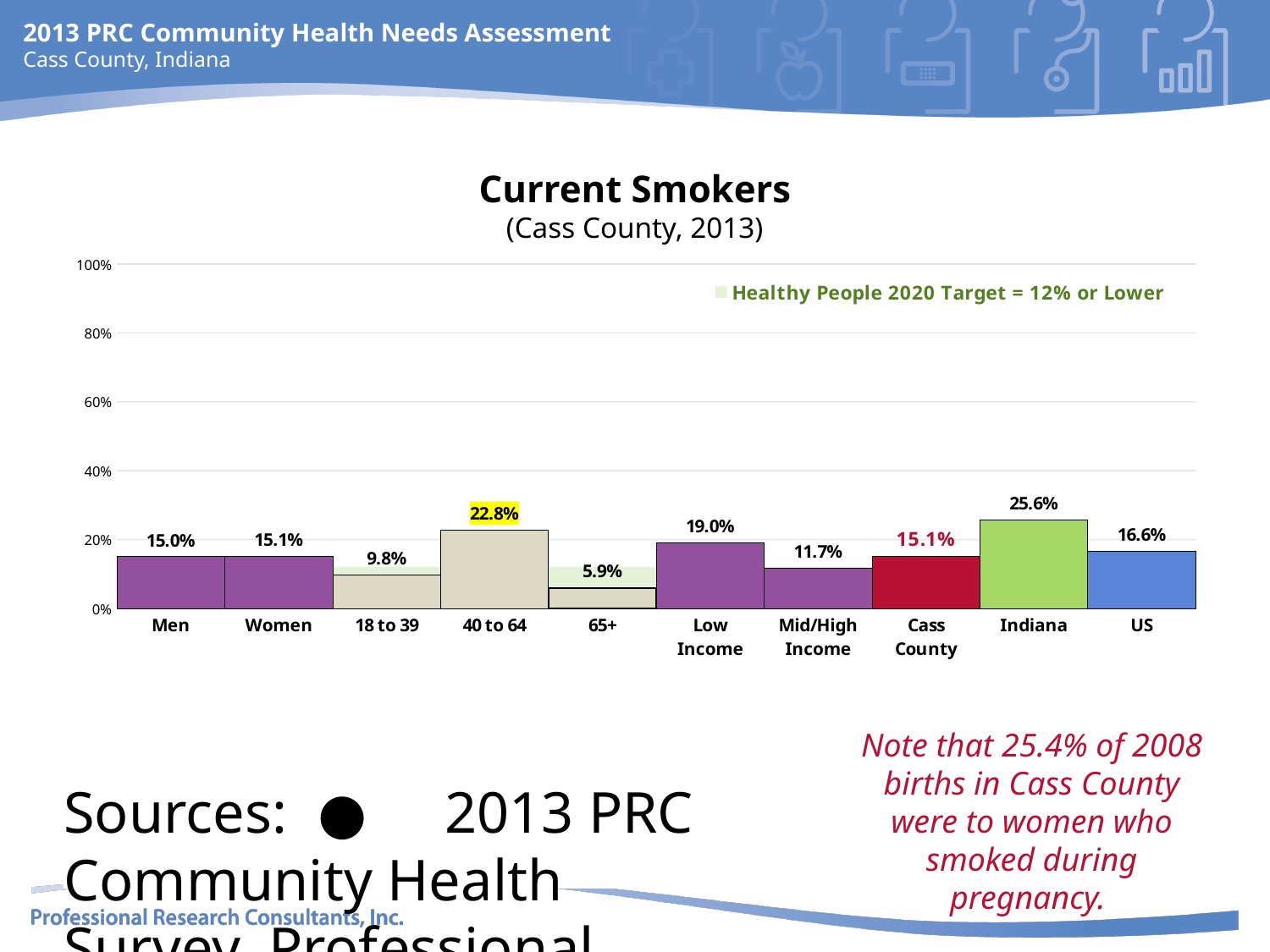
Which is larger in the Current Smokers chart, the value for Indiana or the value for US? Indiana Which category has the lowest value in the Current Smokers chart? 65+ What is the value for Cass County in the Current Smokers chart? 15.1% Is the value for 18 to 39 in the Current Smokers chart greater or less than 20%? less How many categories are shown on the x axis of the Current Smokers chart? 10 What Healthy People 2020 target is stated in the legend of the Current Smokers chart? 12% or Lower What is the difference between the Low Income and Mid/High Income values in the Current Smokers chart? 7.3% What is the value for Indiana in the Current Smokers chart? 25.6% What is the value for 40 to 64 in the Current Smokers chart? 22.8% What kind of chart is the Current Smokers chart? bar chart What is the value for Men in the Current Smokers chart? 15.0% Which category has the highest value in the Current Smokers chart? Indiana